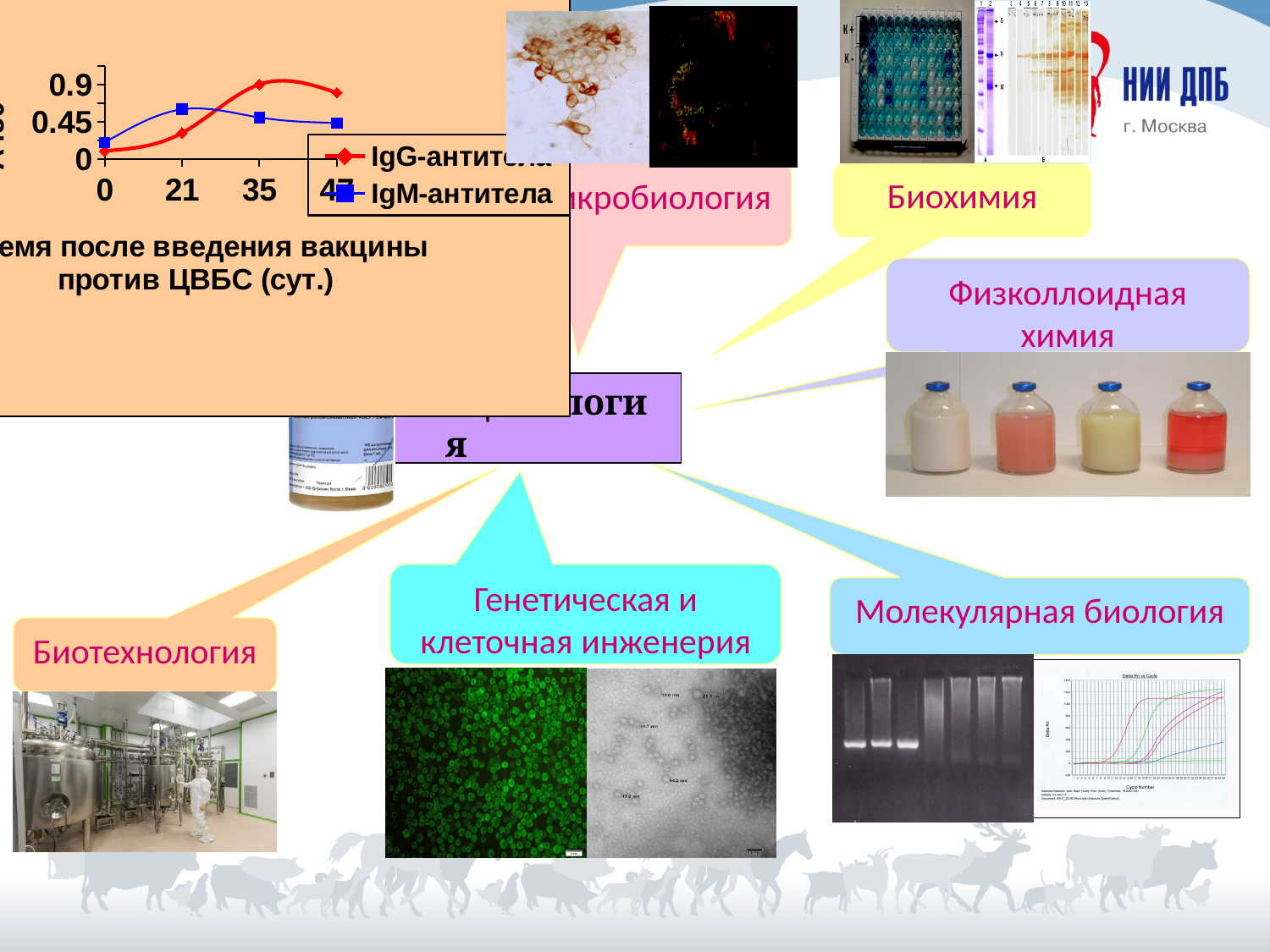
In the top-left line chart, which colour is used for the IgG-антитела series? red What kind of chart is shown in the top-left of the slide? line chart In the top-left line chart, at which x-axis value does the IgG-антитела series reach its highest point? 35 In the top-left line chart, is the IgG-антитела value at 0 days greater or less than 0.45? less In the top-left line chart, is the IgM-антитела value at 0 days greater or less than 0.45? less What are the two series named in the legend of the top-left line chart? IgG-антитела and IgM-антитела In the top-left line chart, which series has the larger value at 35 days, IgG-антитела or IgM-антитела? IgG-антитела In the top-left line chart, does the IgG-антитела series rise or fall between 0 and 35 days? rise In the top-left line chart, is the IgG-антитела value at 35 days greater or less than 0.45? greater In the top-left line chart, which series has the larger value at 21 days, IgG-антитела or IgM-антитела? IgM-антитела How many series does the legend of the top-left line chart list? 2